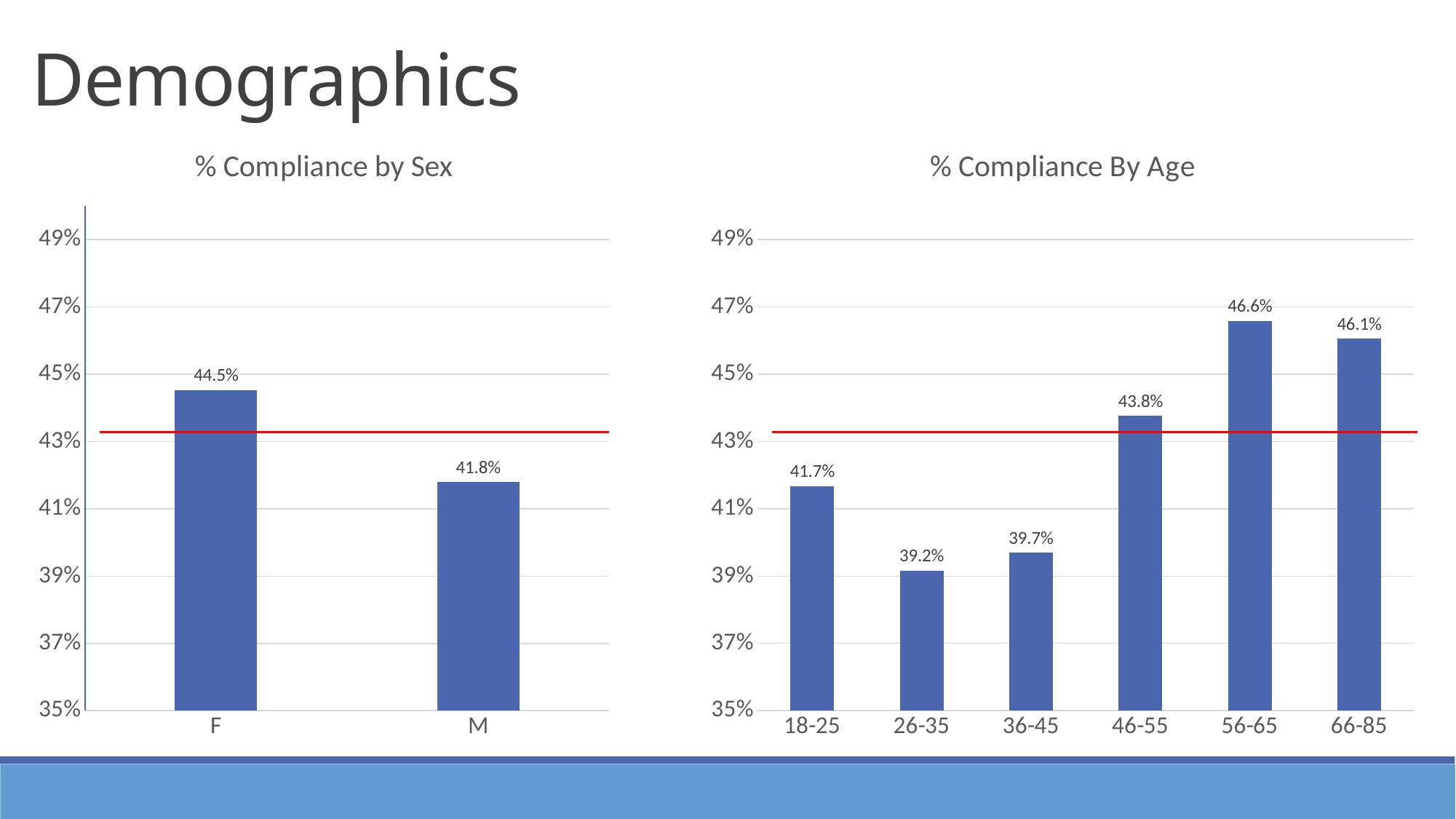
In the '% Compliance by Sex' chart, what is the difference between the values for F and M? 2.7% In the '% Compliance by Sex' chart, what is the value for M? 41.8% In the '% Compliance By Age' chart, what is the value for 26-35? 39.2% What kind of chart is the '% Compliance by Sex' chart? Bar chart In the '% Compliance By Age' chart, which age group has the lowest value? 26-35 In the '% Compliance By Age' chart, what is the value for 56-65? 46.6% In the '% Compliance by Sex' chart, what is the value for F? 44.5% In the '% Compliance by Sex' chart, which category has the higher value, F or M? F In the '% Compliance By Age' chart, how many age groups are shown? 6 In the '% Compliance By Age' chart, is the value for 46-55 greater or less than 43%? greater In the '% Compliance By Age' chart, what is the difference between the values for 66-85 and 18-25? 4.4% In the '% Compliance By Age' chart, which age group has the highest value? 56-65